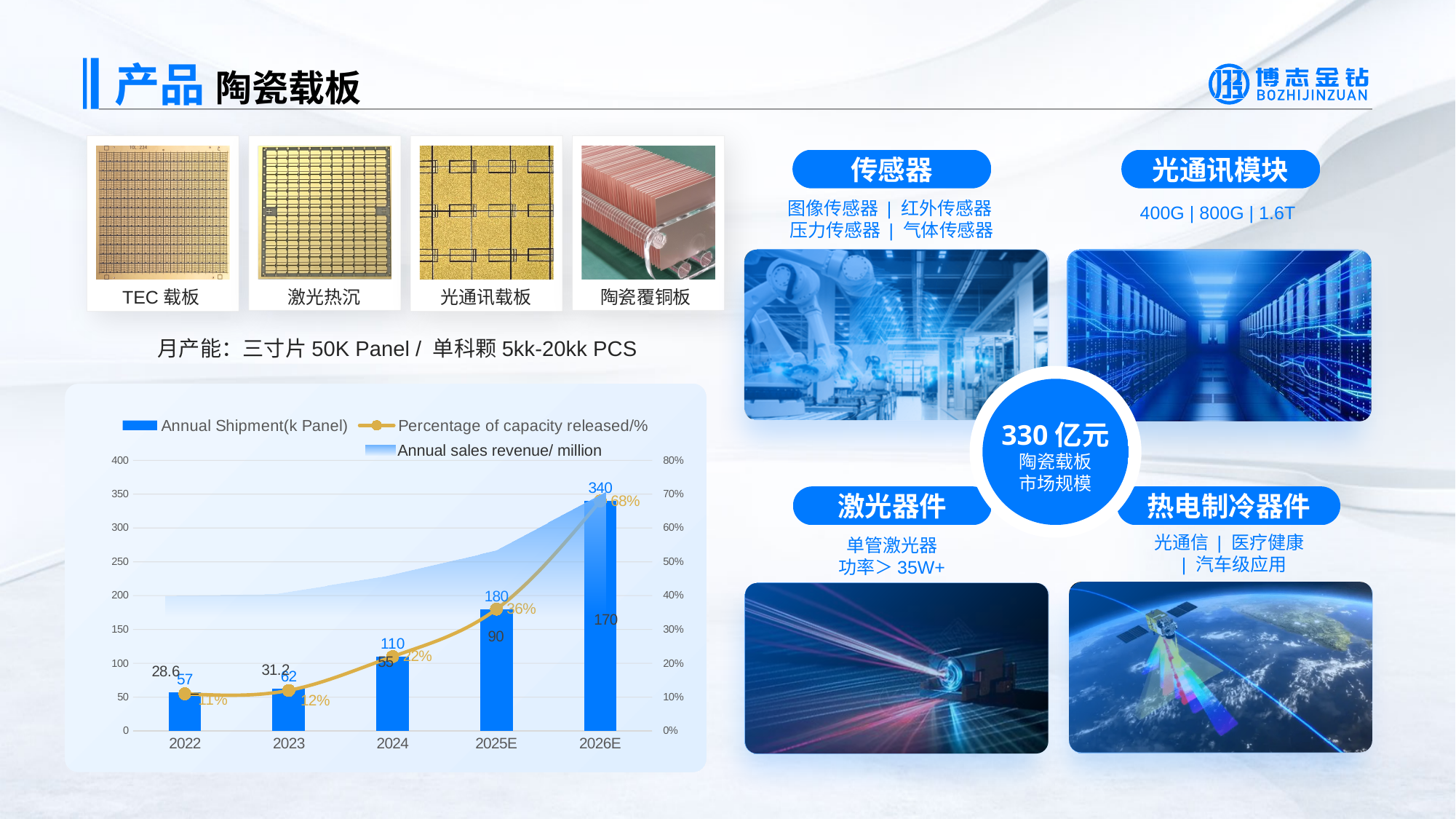
Which year has the highest Annual Shipment (k Panel)? 2026E How many series does the chart legend list? 3 Does the Percentage of capacity released rise or fall from 2022 to 2026E? rise What is the Percentage of capacity released for 2024? 22% What colour are the Annual Shipment bars in the chart? blue What is the difference in Annual Shipment (k Panel) between 2026E and 2025E? 160 How many years are shown on the x axis of the chart? 5 What is the Annual Shipment (k Panel) value for 2026E? 340 Which is larger, the Annual sales revenue for 2023 or for 2024? 2024 Which year has the lowest Percentage of capacity released? 2022 What is the Annual sales revenue (million) for 2025E? 90 What is the Annual sales revenue (million) for 2022? 28.6